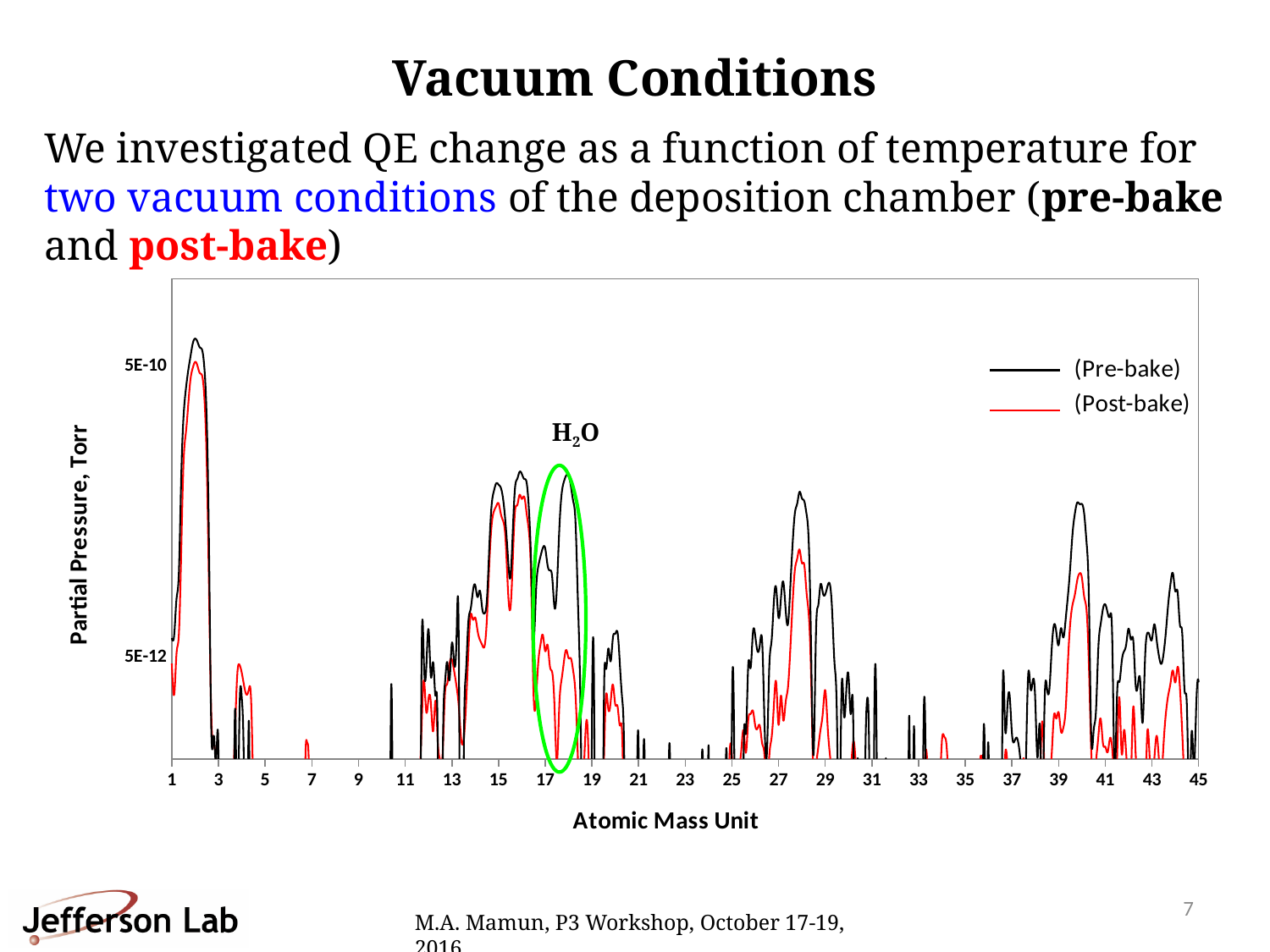
At atomic mass unit 28, which series has the higher partial pressure, Pre-bake or Post-bake? Pre-bake At which atomic mass unit does the Pre-bake series reach its highest peak? 2 How many series does the legend list? 2 At atomic mass unit 18, which series has the higher partial pressure, Pre-bake or Post-bake? Pre-bake Which molecule is labelled above the green circle on the chart? H2O Is the Post-bake peak at atomic mass unit 28 greater or less than 5E-12 Torr? greater What kind of chart is shown on the slide? line chart Is the Pre-bake peak at atomic mass unit 2 greater or less than 5E-10 Torr? greater Is the Pre-bake peak at atomic mass unit 28 greater or less than 5E-10 Torr? less Which series is drawn in red? (Post-bake)